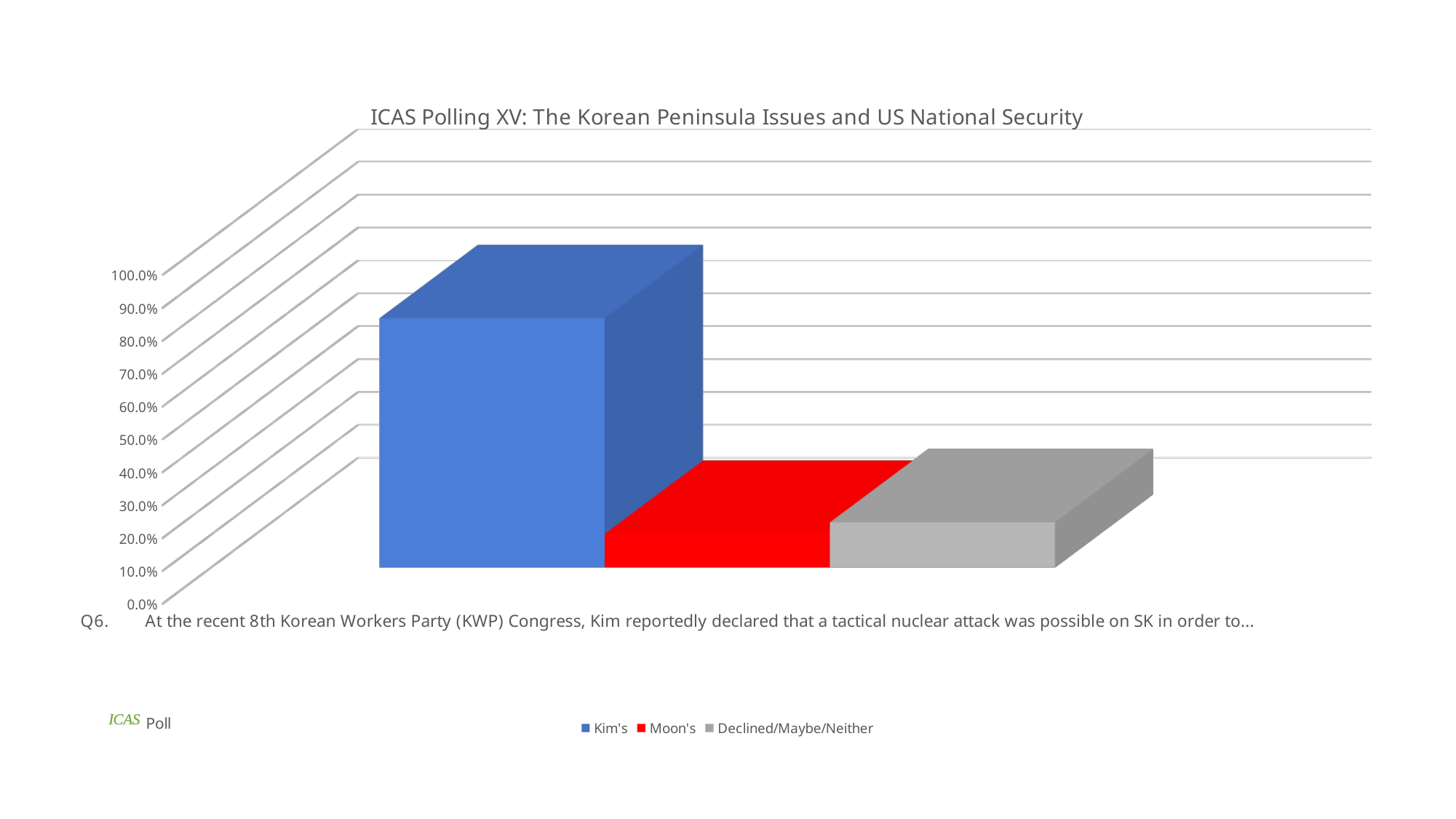
What colour represents the Moon's series in the chart? red How many bars are plotted in the chart? 3 Is the value for Kim's greater or less than 90.0%? less Which series has the highest value? Kim's Is the value for Declined/Maybe/Neither greater or less than 30.0%? less How many series does the legend list? 3 What kind of chart is shown on the slide? bar chart Which is larger, the value for Kim's or the value for Moon's? Kim's What is the title of the chart? ICAS Polling XV: The Korean Peninsula Issues and US National Security Which is larger, the value for Kim's or the value for Declined/Maybe/Neither? Kim's Is the value for Moon's greater or less than 30.0%? less